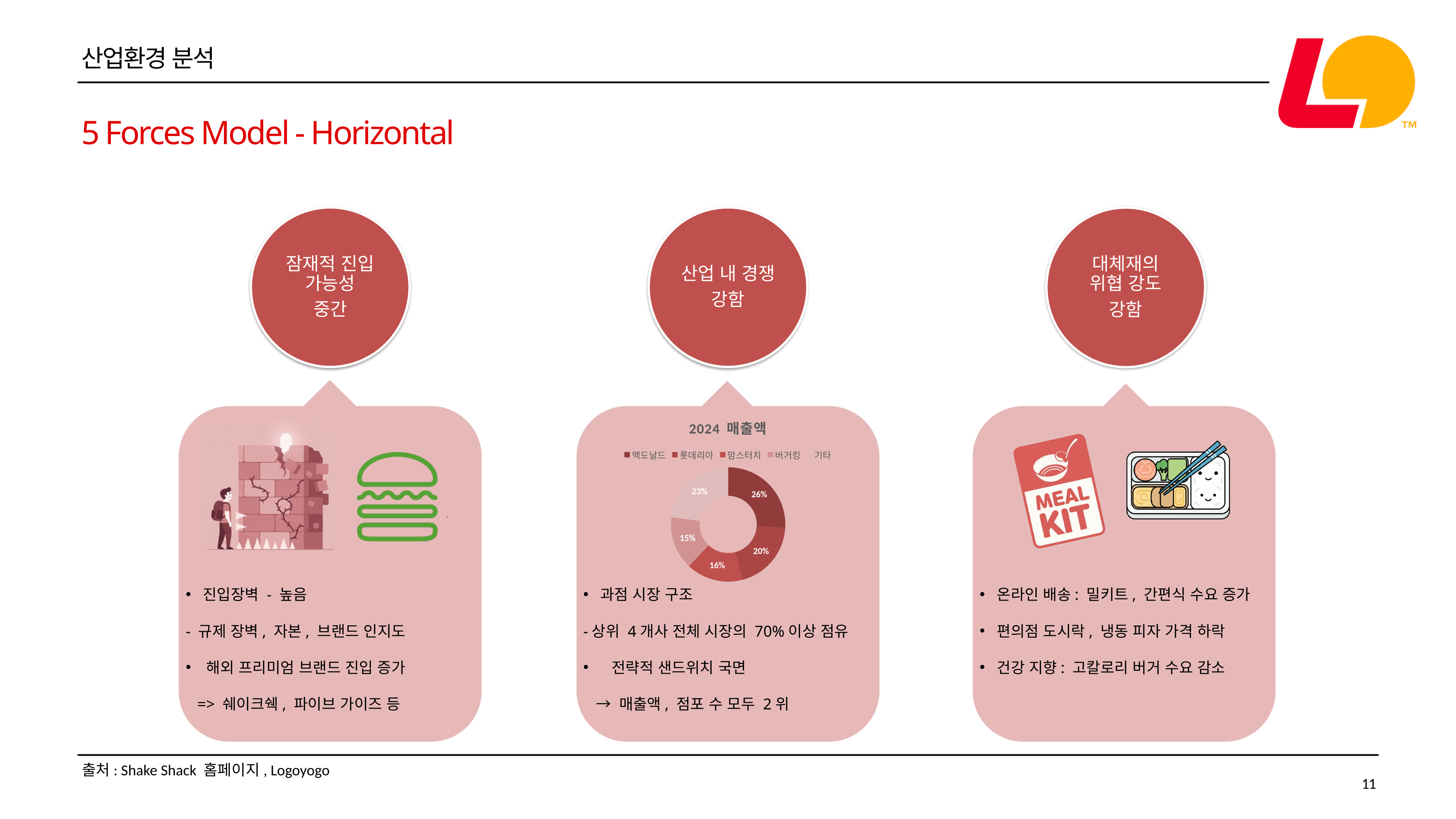
In the 2024 매출액 chart, what share does 롯데리아 have? 20% In the 2024 매출액 chart, what share does 맘스터치 have? 16% What is the title of the chart on the slide? 2024 매출액 How many categories does the legend of the 2024 매출액 chart list? 5 What kind of chart is shown under the '산업 내 경쟁' heading? pie chart (donut) In the 2024 매출액 chart, what share does 버거킹 have? 15% In the 2024 매출액 chart, what is the difference between the shares of 맥도날드 and 롯데리아? 6% In the 2024 매출액 chart, which has a larger share, 기타 or 롯데리아? 기타 Which category has the smallest share in the 2024 매출액 chart? 버거킹 Which category has the largest share in the 2024 매출액 chart? 맥도날드 In the 2024 매출액 chart, what share does 맥도날드 have? 26% In the 2024 매출액 chart, what share does 기타 have? 23%